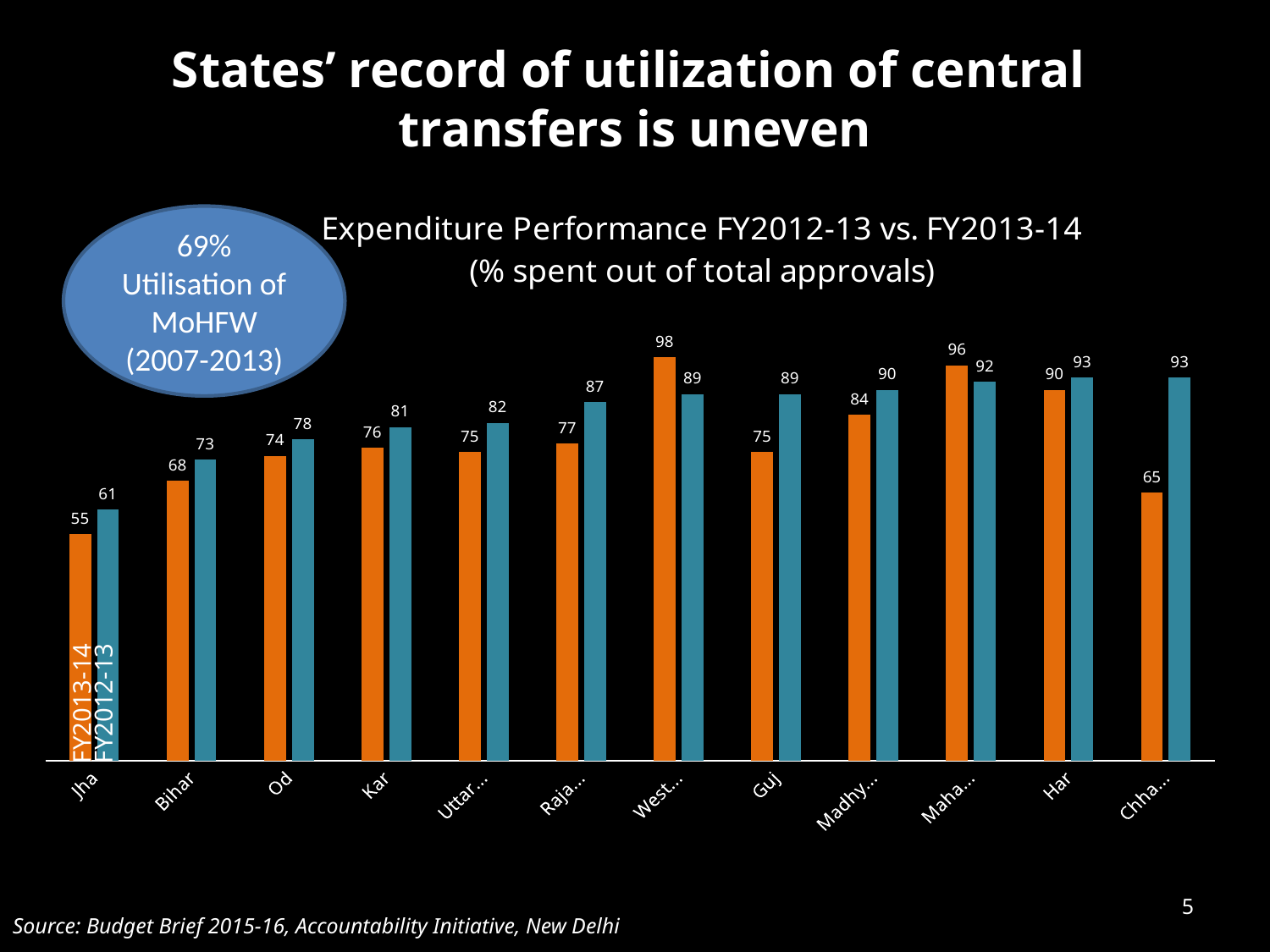
Which is larger, the FY2013-14 value for Kar or the FY2013-14 value for Bihar? Kar What is the difference between the FY2012-13 and FY2013-14 values for Har? 3 How many states are shown on the x axis of the chart? 12 What is the difference between the FY2012-13 and FY2013-14 values for Jha? 6 Which state has the lowest FY2012-13 value? Jha What type of chart is shown on the slide? Bar chart What is the FY2013-14 value for Bihar? 68 What is the FY2012-13 value for Od? 78 For Guj, which series has the larger value, FY2013-14 or FY2012-13? FY2012-13 What is the FY2012-13 value for Guj? 89 How many series does the chart show? 2 Which state has the lowest FY2013-14 value? Jha